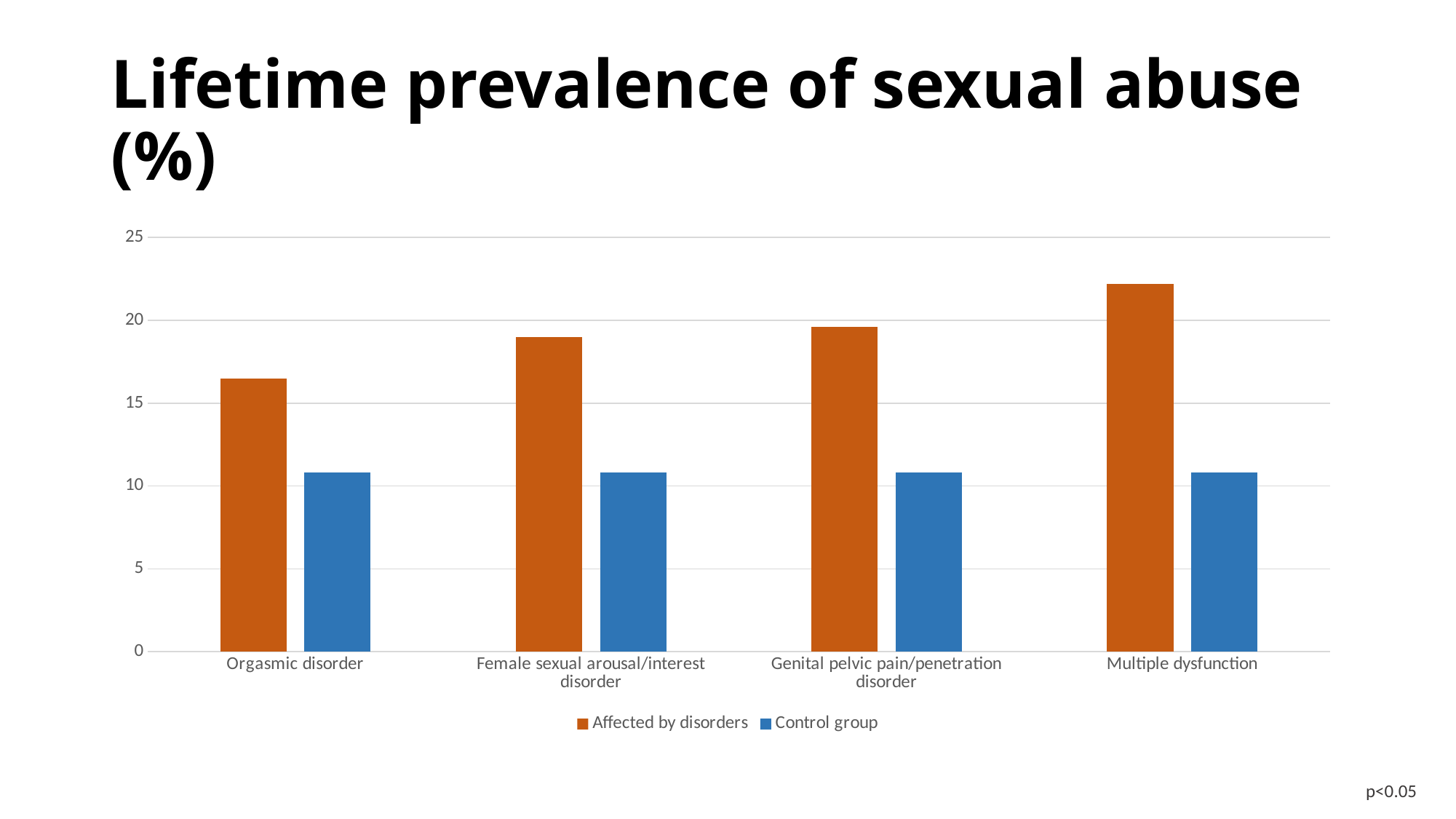
How many categories are shown on the x axis? 4 What colour are the Control group bars? blue Is the Affected by disorders value for Multiple dysfunction greater or less than 20? greater For Genital pelvic pain/penetration disorder, which is larger: Affected by disorders or Control group? Affected by disorders Is the Affected by disorders value for Orgasmic disorder greater or less than 15? greater What kind of chart is shown on the slide? bar chart Which category has the lowest value for Affected by disorders? Orgasmic disorder How many series does the legend list? 2 Is the Control group value for Orgasmic disorder greater or less than 15? less Do the Affected by disorders values rise or fall from left to right along the x axis? rise Which category has the highest value for Affected by disorders? Multiple dysfunction